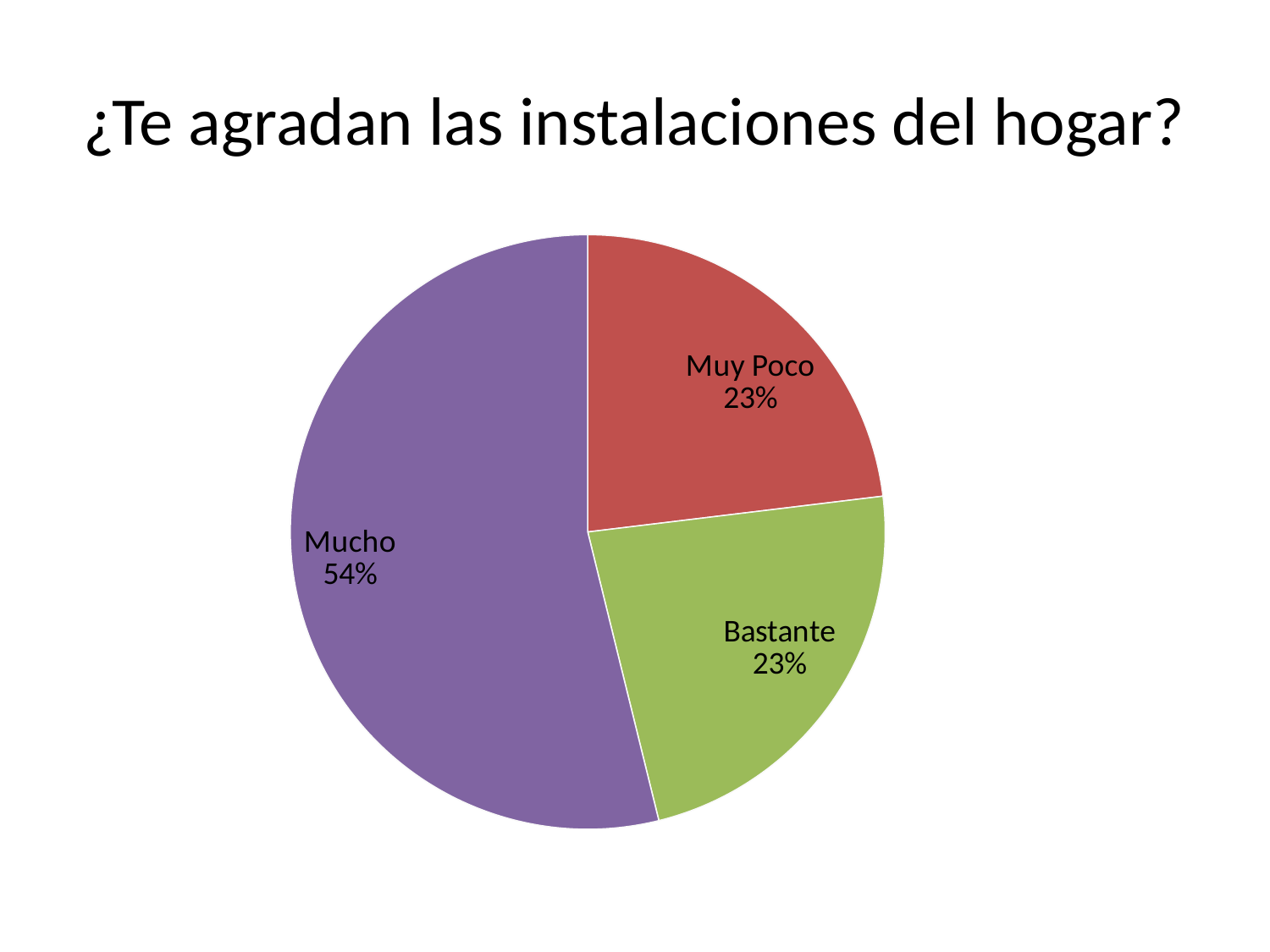
What is the title of the chart on the slide? ¿Te agradan las instalaciones del hogar? Which is larger, the "Mucho" slice or the "Muy Poco" slice? Mucho Which category has the largest slice of the pie? Mucho What colour is the "Mucho" slice of the pie? purple What share of the pie does the "Mucho" slice represent? 54% What share of the pie does the "Bastante" slice represent? 23% What kind of chart is shown on the slide? pie chart What is the difference in percentage points between the "Mucho" slice and the "Bastante" slice? 31 Is the share for "Mucho" greater or less than 50%? greater How many slices does the pie chart have? 3 What share of the pie does the "Muy Poco" slice represent? 23%